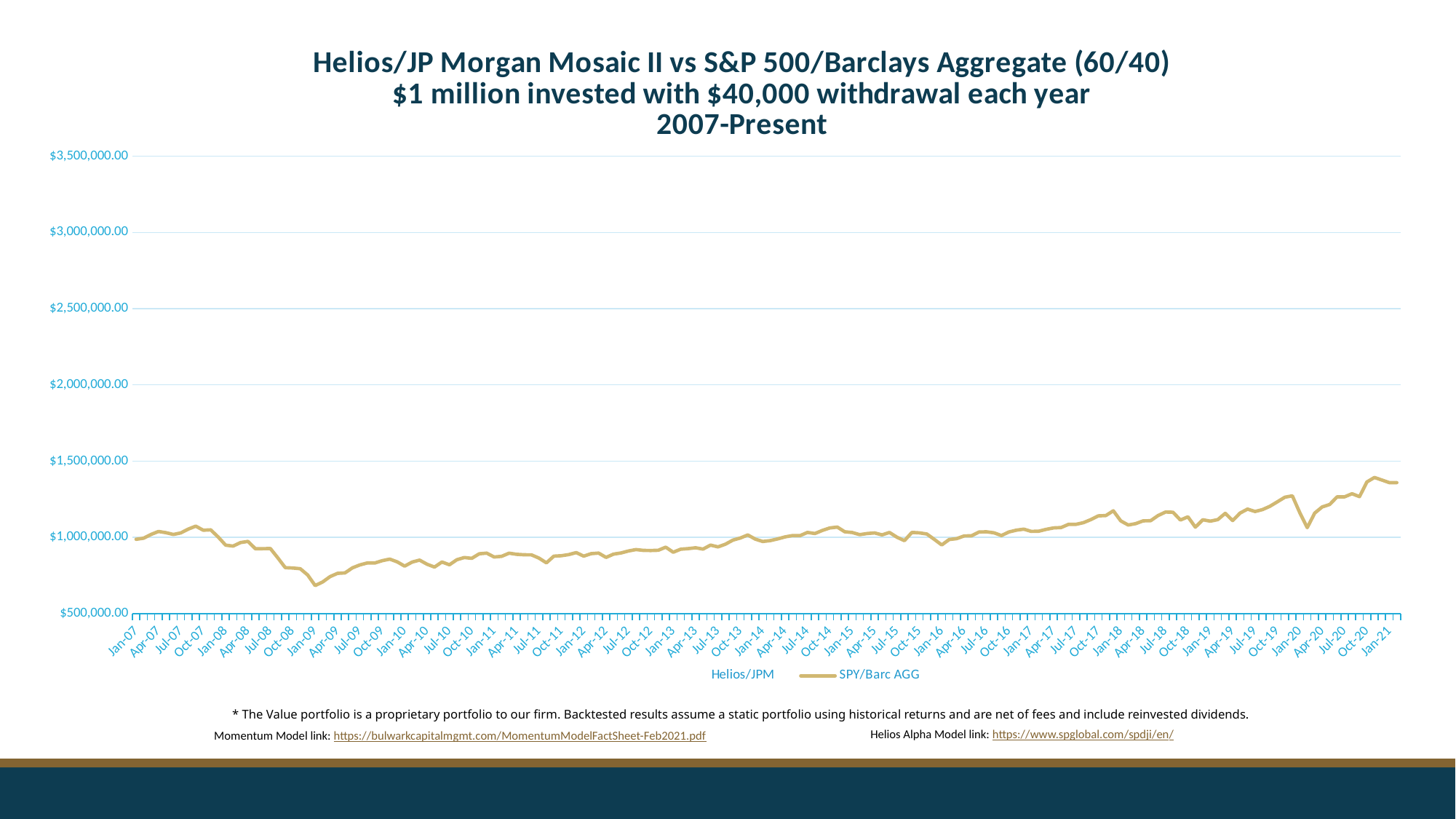
How many series does the legend list? 2 Which is larger for the SPY/Barc AGG line: the value at Jan-07 or the value at Jan-21? Jan-21 Which is larger for the SPY/Barc AGG line: the value at Jan-09 or the value at Jan-21? Jan-21 Is the SPY/Barc AGG value at Jan-21 greater or less than $1,000,000.00? greater What kind of chart is shown on the slide? line chart What are the two series names listed in the legend? Helios/JPM and SPY/Barc AGG Is the SPY/Barc AGG value at Jan-18 greater or less than $1,000,000.00? greater Is the SPY/Barc AGG value at Jan-21 greater or less than $1,500,000.00? less Over the whole period from Jan-07 to Jan-21, does the SPY/Barc AGG line overall rise or fall? rise In which year does the SPY/Barc AGG line reach its lowest point? 2009